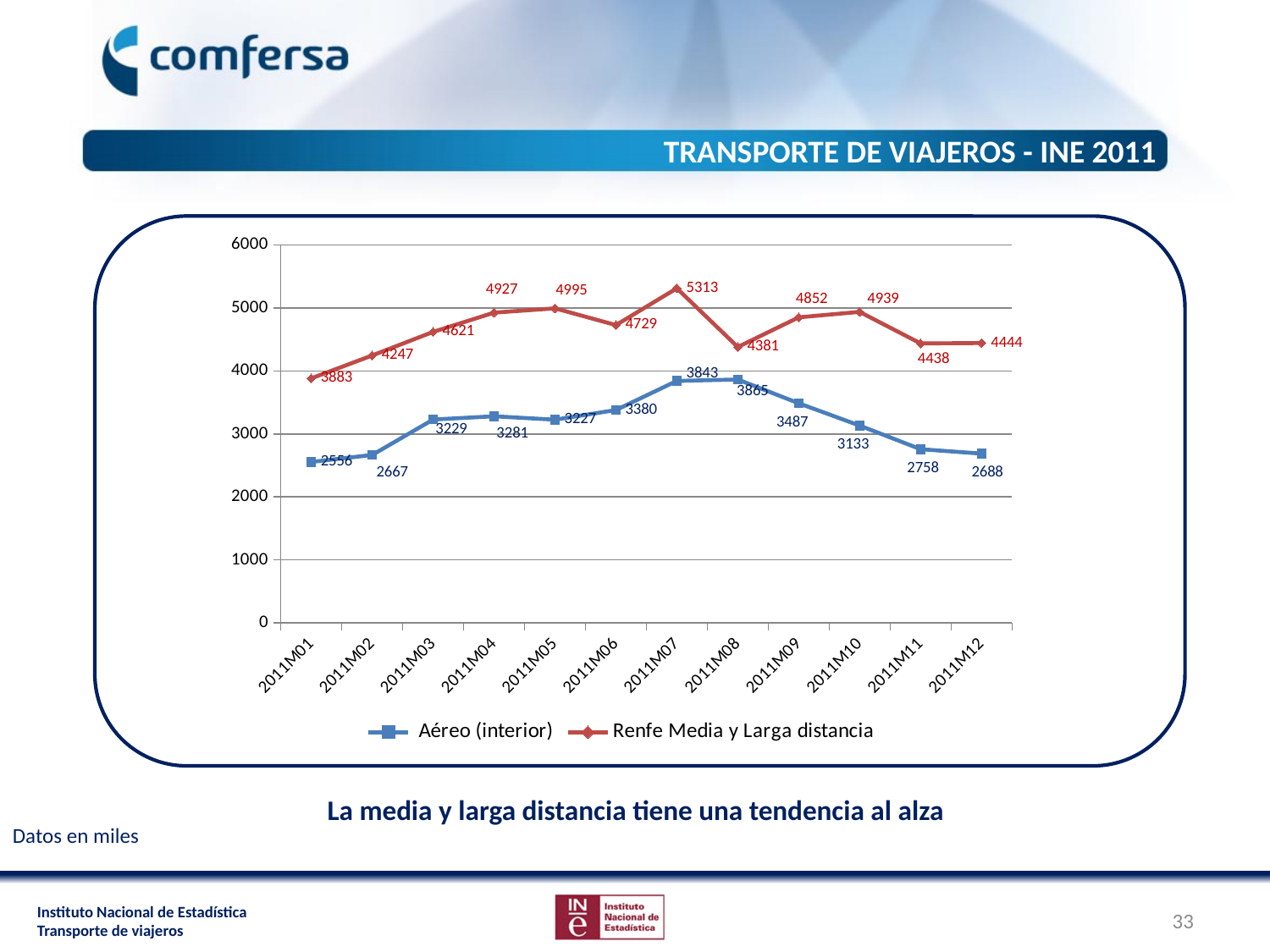
How many months are plotted on the x axis? 12 Is the value for Aéreo (interior) in 2011M08 greater or less than 3000? greater What is the value for Aéreo (interior) in 2011M01? 2556 In which month does Renfe Media y Larga distancia reach its highest value? 2011M07 What is the value for Renfe Media y Larga distancia in 2011M07? 5313 How many series does the legend list? 2 Which series has the larger value in 2011M12, Aéreo (interior) or Renfe Media y Larga distancia? Renfe Media y Larga distancia What kind of chart is shown on the slide? line chart In which month does Aéreo (interior) reach its highest value? 2011M08 In which month is the Renfe Media y Larga distancia value lowest? 2011M01 What is the difference between Renfe Media y Larga distancia and Aéreo (interior) in 2011M07? 1470 What is the value for Aéreo (interior) in 2011M12? 2688